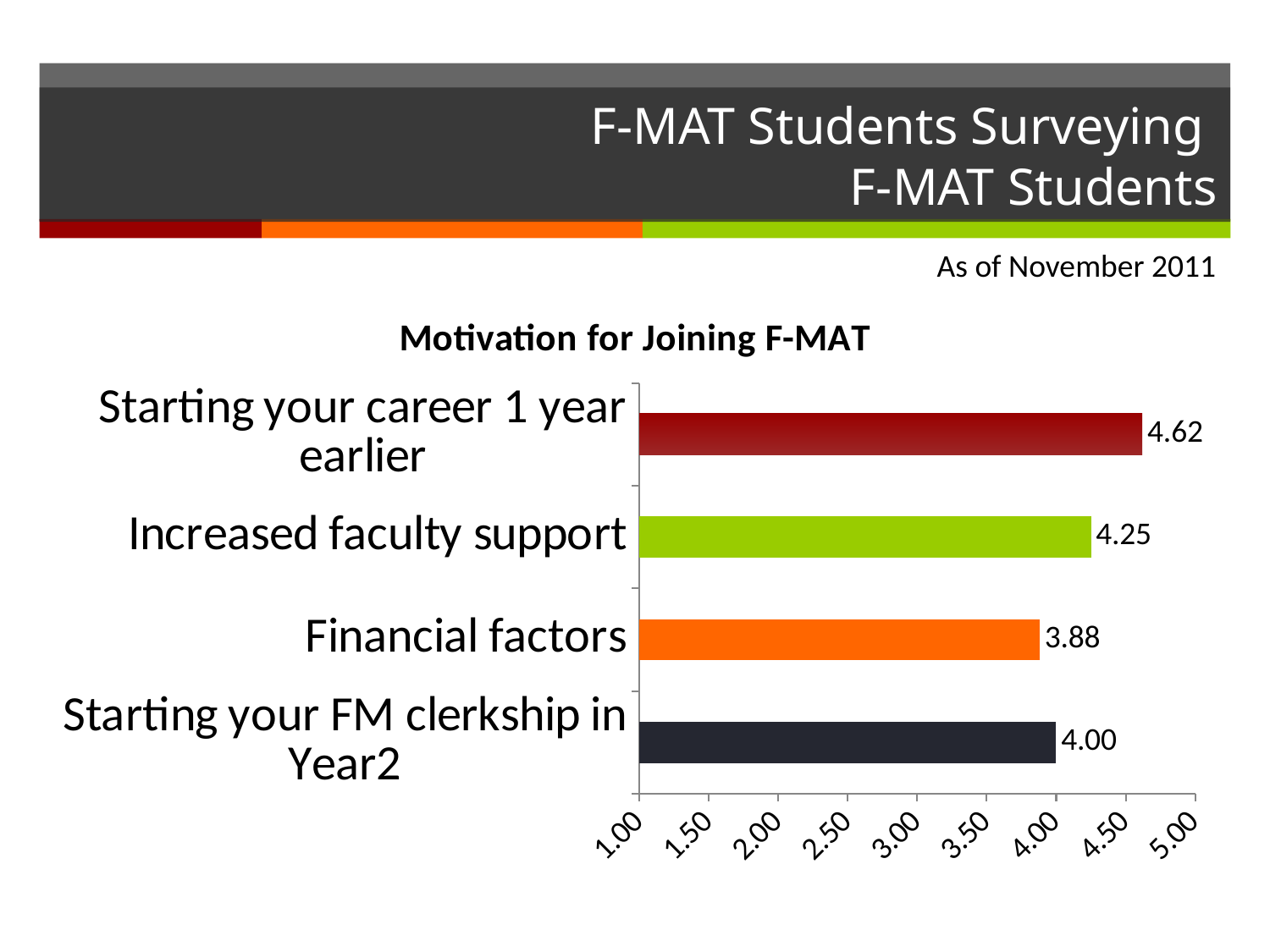
Which category has the highest value? Starting your career 1 year earlier How many categories are shown in the chart? 4 What is the value for Starting your career 1 year earlier? 4.62 Is the value for Financial factors greater or less than 4.00? less Which category has the lowest value? Financial factors What is the difference between the values for Starting your career 1 year earlier and Increased faculty support? 0.37 What is the value for Increased faculty support? 4.25 Which is larger, the value for Increased faculty support or the value for Starting your FM clerkship in Year2? Increased faculty support What is the title of the chart? Motivation for Joining F-MAT What kind of chart is shown on the slide? bar chart What is the value for Starting your FM clerkship in Year2? 4.00 What is the value for Financial factors? 3.88